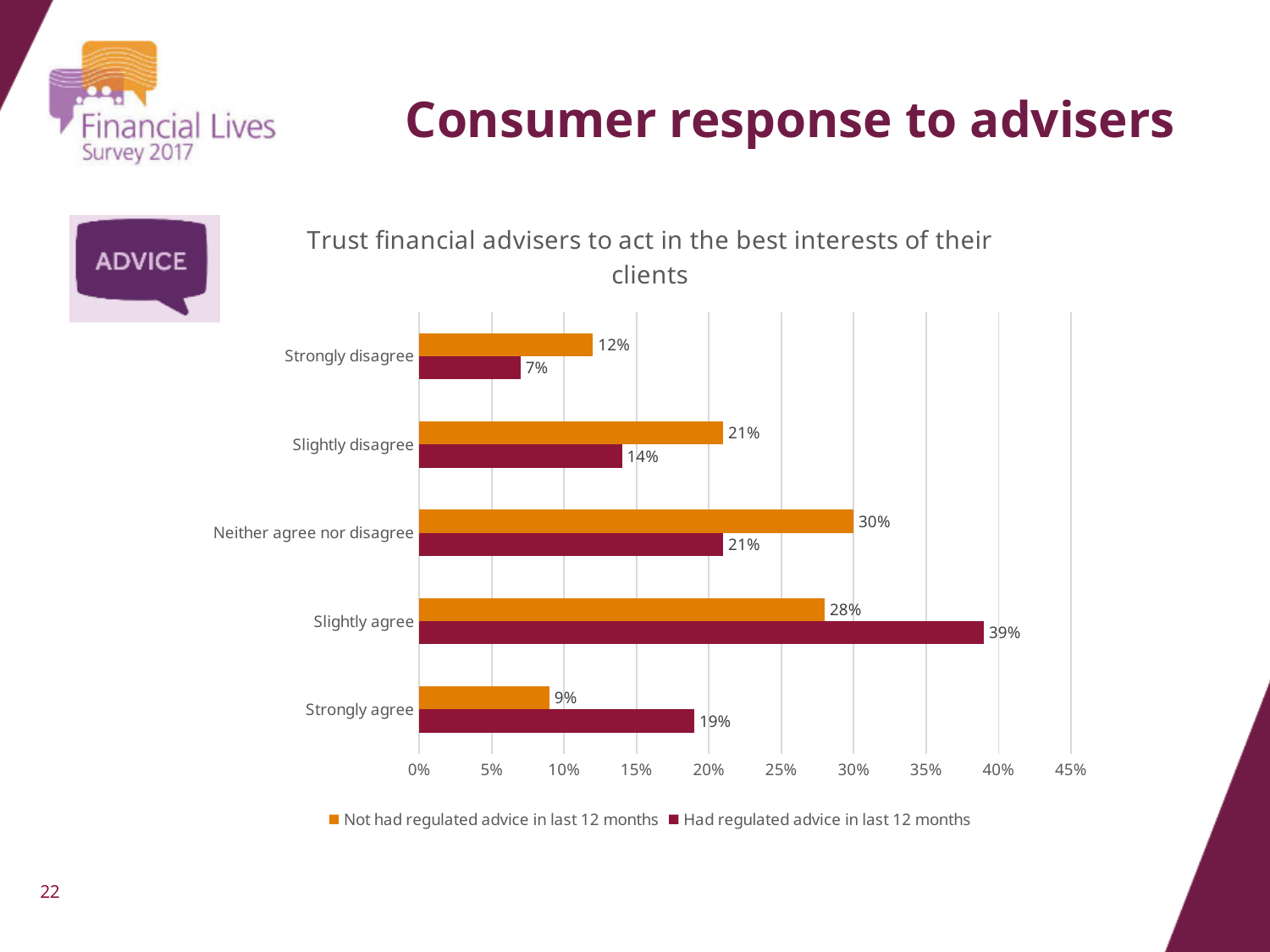
What is the difference between the 'Slightly agree' values for those who had regulated advice and those who had not? 11 percentage points Which response category has the lowest value for those who had regulated advice in the last 12 months? Strongly disagree What is the title of the chart? Trust financial advisers to act in the best interests of their clients What percentage of those who had regulated advice in the last 12 months strongly agree? 19% How many response categories are shown on the chart? 5 What percentage of those who had regulated advice in the last 12 months slightly agree that they trust financial advisers to act in the best interests of their clients? 39% What is the value for 'Strongly disagree' among those who had not had regulated advice in the last 12 months? 12% What type of chart is shown on the slide? Bar chart Which response category has the highest value for those who had not had regulated advice in the last 12 months? Neither agree nor disagree Which colour represents 'Had regulated advice in last 12 months' in the legend? Dark red/maroon How many series does the legend list? 2 For 'Neither agree nor disagree', which group has the larger value: those who had regulated advice or those who had not? Not had regulated advice in last 12 months